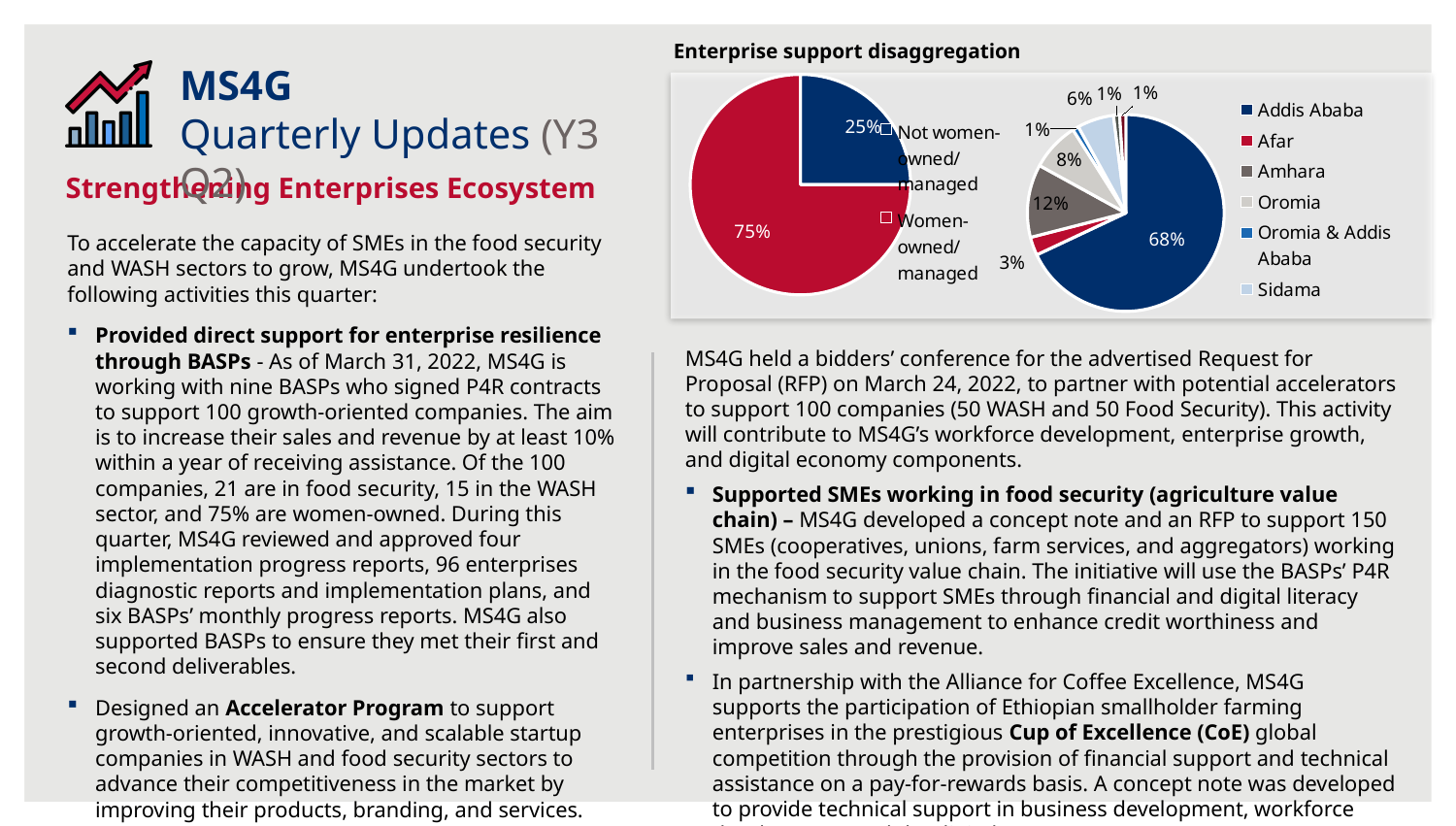
How many slices does the left pie chart have? 2 In the left pie chart, what share of enterprises is Not women-owned/managed? 25% What type of charts are shown under 'Enterprise support disaggregation'? Pie charts In the right pie chart, what is the share for Amhara? 12% How many entries does the legend of the right pie chart list? 6 In the left pie chart, what share of enterprises is Women-owned/managed? 75% In the left pie chart, which category has the larger share? Women-owned/managed In the right pie chart, which has the larger share, Amhara or Oromia? Amhara In the right pie chart, what is the share for Afar? 3% In the right pie chart, what is the share for Addis Ababa? 68% In the right pie chart, which region has the largest share? Addis Ababa In the right pie chart, what is the difference in percentage points between Addis Ababa and Amhara? 56